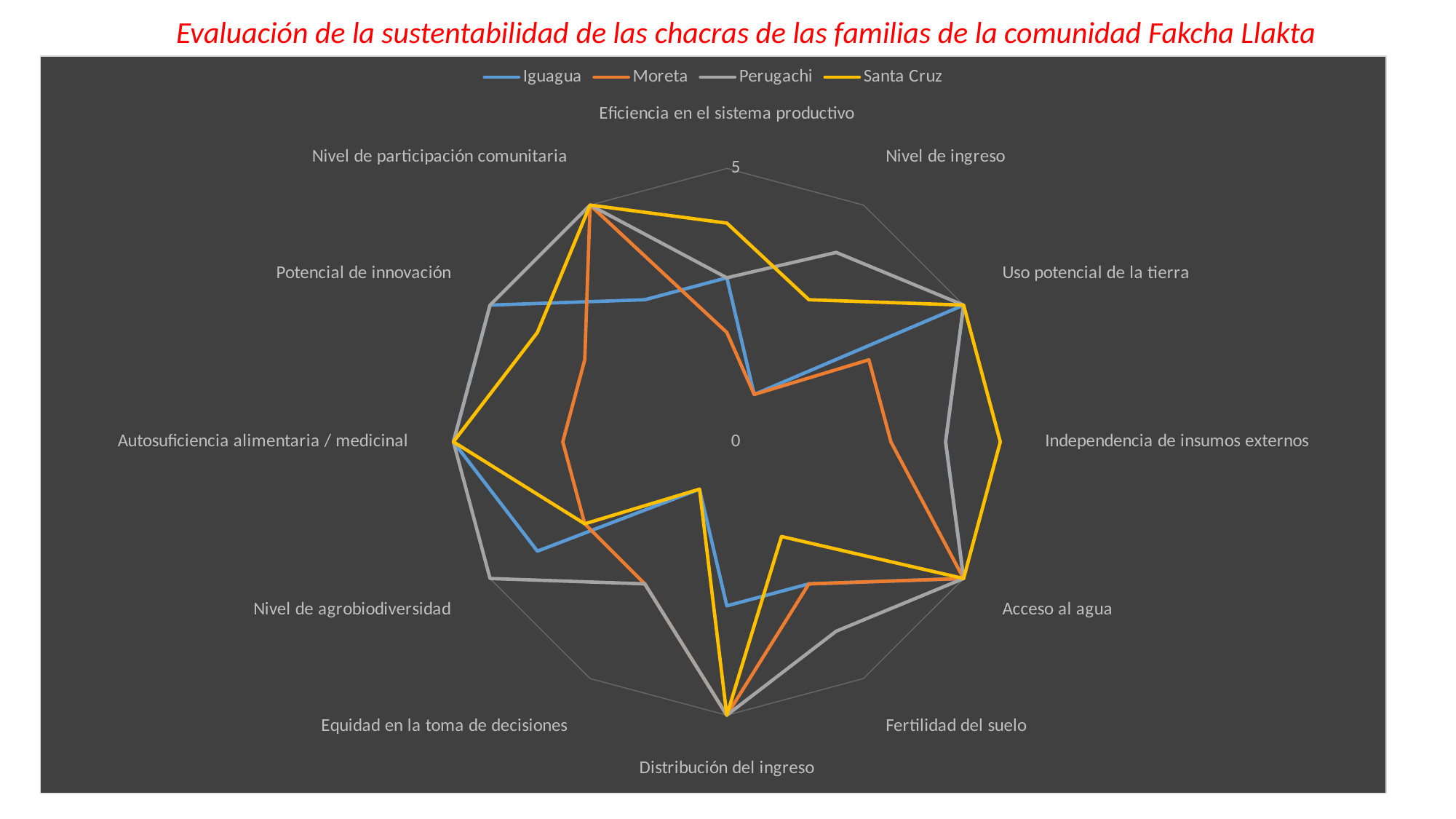
Which family has the lowest value for Distribución del ingreso? Iguagua Which family has the highest value for Equidad en la toma de decisiones? Moreta and Perugachi (tied) Which family has the lowest value for Eficiencia en el sistema productivo? Moreta Which family is plotted with the yellow line? Santa Cruz Which family has the highest value for Nivel de agrobiodiversidad? Perugachi Which family has the lowest value for Uso potencial de la tierra? Moreta What kind of chart is shown on the slide? Radar chart Which family has the highest value for Eficiencia en el sistema productivo? Santa Cruz How many series does the legend list? 4 How many indicator categories (axes) does the radar chart have? 12 What is the title of the slide? Evaluación de la sustentabilidad de las chacras de las familias de la comunidad Fakcha Llakta